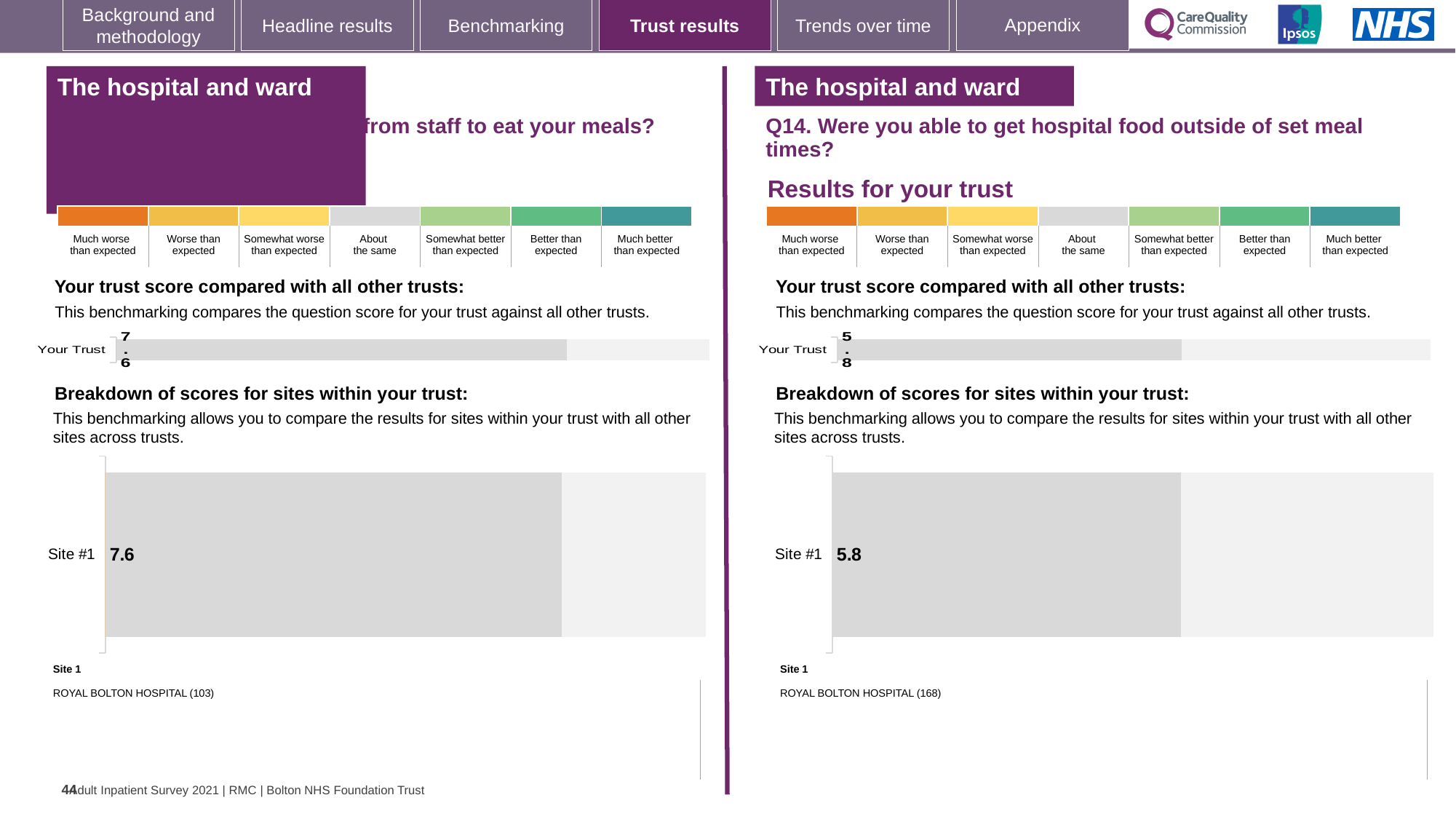
Which is larger: the Site #1 score in the left-hand breakdown chart or the Site #1 score in the right-hand (Q14) breakdown chart? The left-hand chart (7.6) What is the difference between the Site #1 score in the left-hand breakdown chart (7.6) and the Site #1 score in the right-hand Q14 breakdown chart (5.8)? 1.8 How many sites are shown in the Q14 'Breakdown of scores for sites within your trust' chart on the right? 1 On the right-hand side of the slide (Q14), what is the trust score shown in the 'Your trust score compared with all other trusts' chart? 5.8 Is the trust score in the right-hand Q14 'Your Trust' chart greater or less than the trust score in the left-hand 'Your Trust' chart? less In the Q14 'Breakdown of scores for sites within your trust' chart on the right, what is the score for Site #1? 5.8 In the left-hand breakdown chart, which site name is listed for Site 1? ROYAL BOLTON HOSPITAL (103) On the left-hand side of the slide, what is the trust score shown in the 'Your trust score compared with all other trusts' chart? 7.6 In the right-hand Q14 breakdown chart, which site name is listed for Site 1? ROYAL BOLTON HOSPITAL (168) What type of chart is used to show the Site #1 score in the breakdown charts on this slide? Bar chart In the 'Breakdown of scores for sites within your trust' chart on the left-hand side, what is the score for Site #1? 7.6